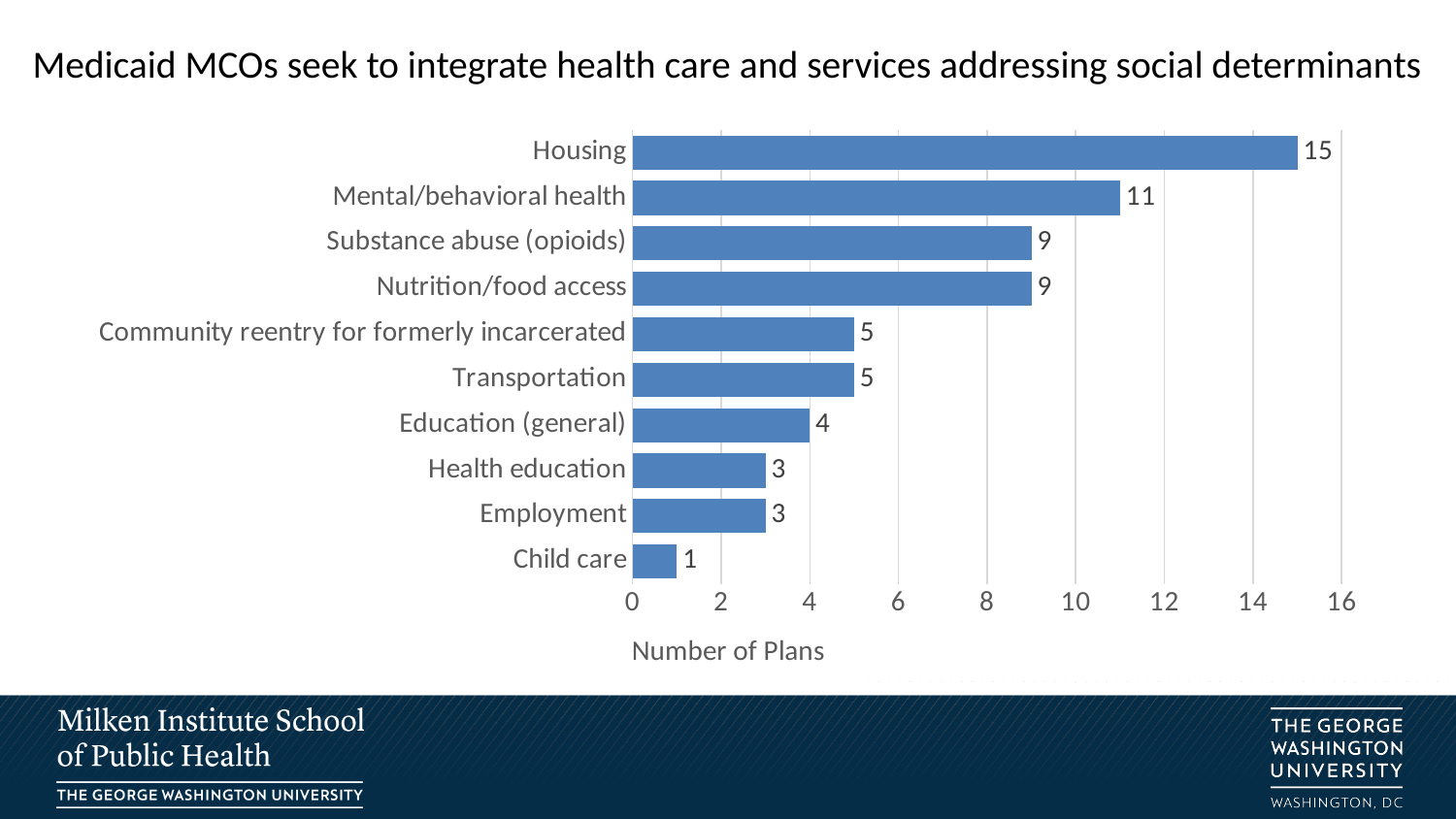
What is the difference in number of plans between Housing and Mental/behavioral health? 4 What kind of chart is shown on the slide? Bar chart How many categories are shown in the chart? 10 Which has more plans, Substance abuse (opioids) or Education (general)? Substance abuse (opioids) What is the label of the horizontal axis? Number of Plans Which category has the highest number of plans? Housing How many plans address Transportation? 5 Which category has the lowest number of plans? Child care How many plans address Housing? 15 What is the number of plans for Mental/behavioral health? 11 Is the value for Nutrition/food access greater or less than 8? greater What is the number of plans for Child care? 1